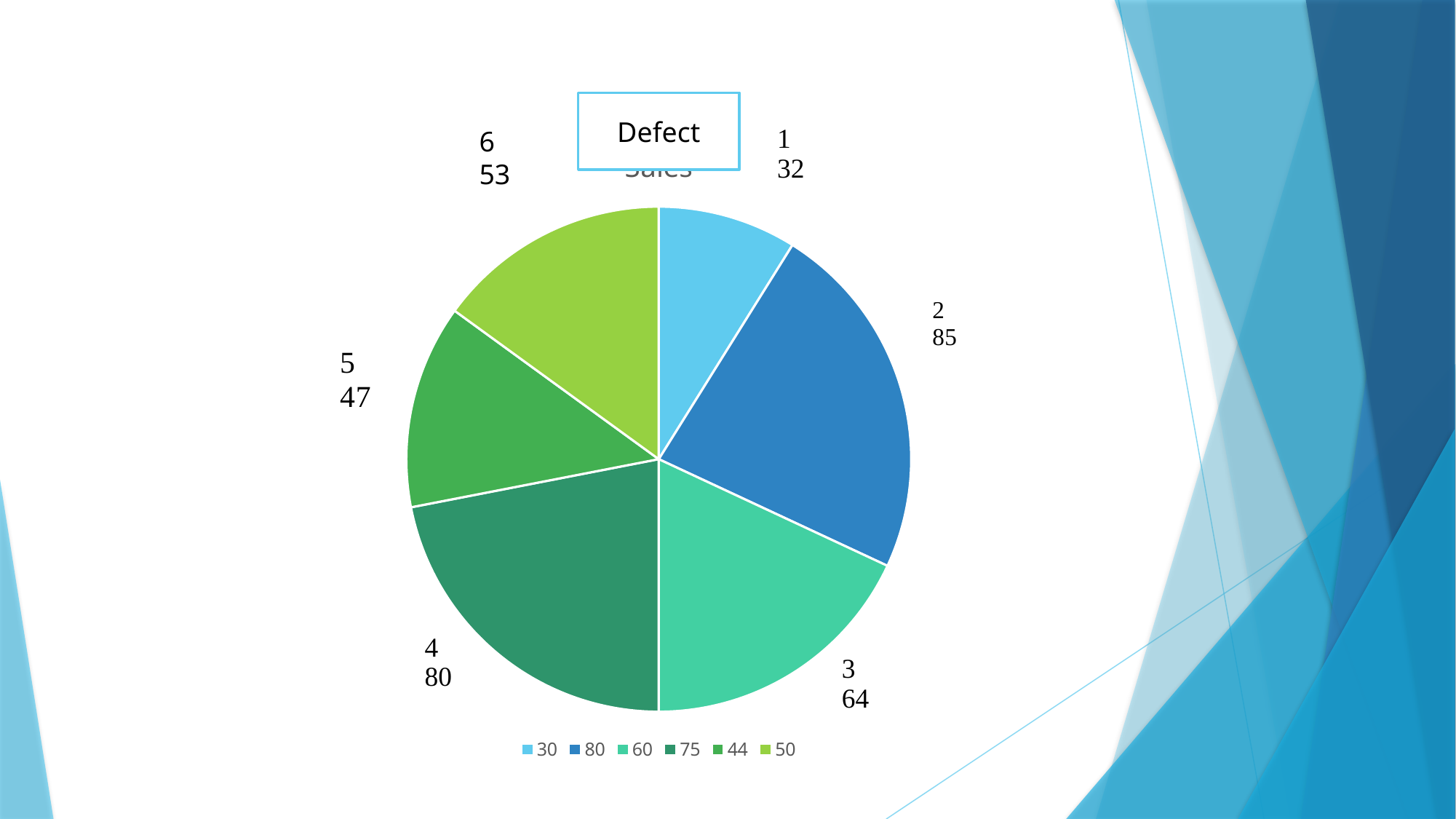
Which slice of the pie chart has the smallest labelled value? 1 How many entries does the legend of the pie chart list? 6 How many slices does the pie chart have? 6 What type of chart is shown on the slide? pie chart What is the difference between the labelled values of slice 3 and slice 5? 17 Which slice of the pie chart has the largest labelled value? 2 What is the value labelled for slice 2 of the pie chart? 85 What text is in the box overlapping the title of the pie chart? Defect Which has the larger labelled value, slice 3 or slice 4? slice 4 What is the value labelled for slice 4 of the pie chart? 80 What is the difference between the labelled values of slice 2 and slice 1? 53 What is the value labelled for slice 6 of the pie chart? 53